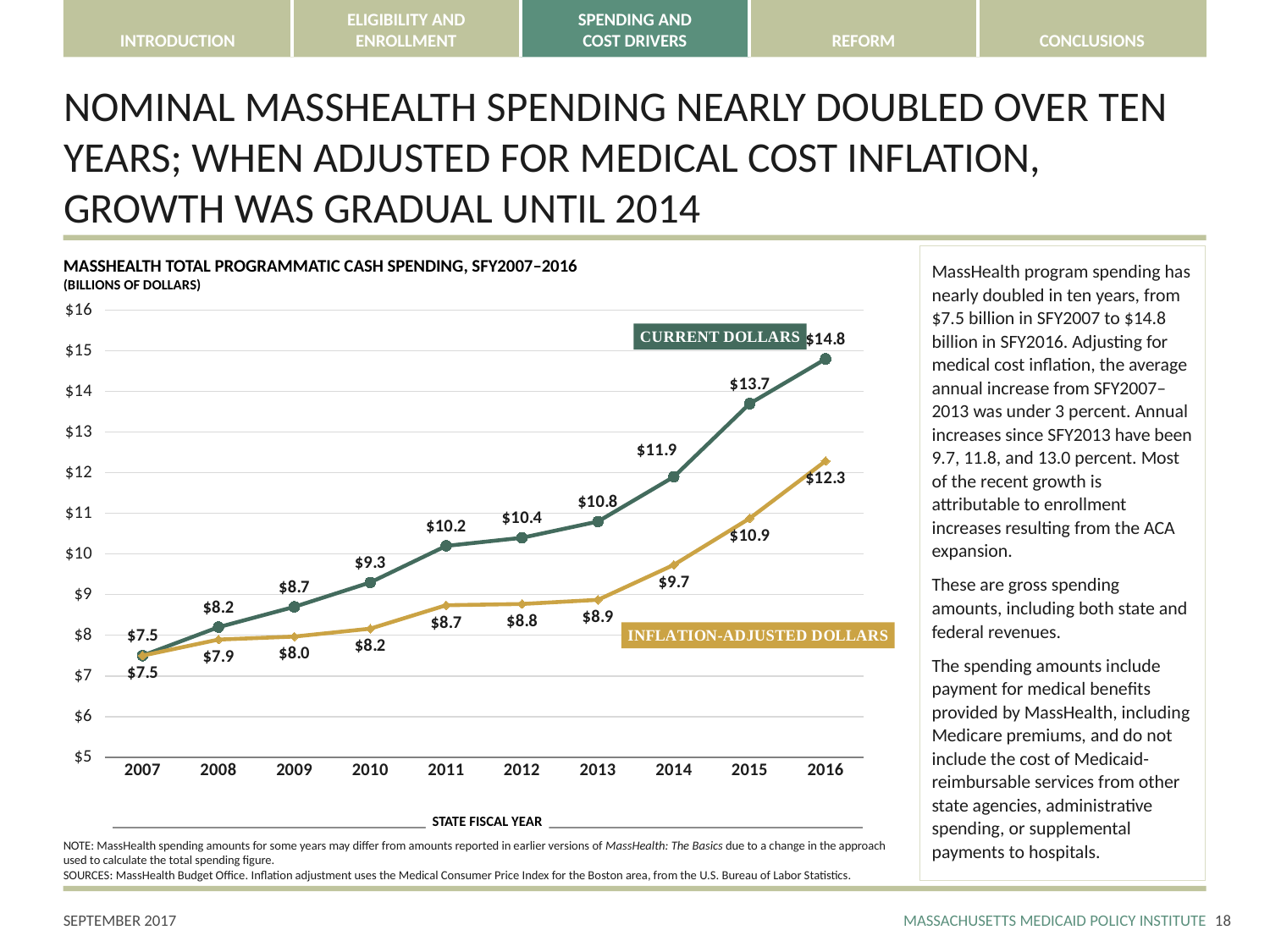
What is the difference between current dollars and inflation-adjusted dollars in 2015? $2.8 In which year was inflation-adjusted spending lowest? 2007 What is the label on the x axis? STATE FISCAL YEAR Which is larger in 2014: current dollars or inflation-adjusted dollars? Current dollars What was the inflation-adjusted spending value for 2013? $8.9 In which year was current-dollar spending highest? 2016 What kind of chart is this? Line chart How many years are shown on the x axis? 10 How many data series does the chart show? 2 What was the current-dollar spending value for 2011? $10.2 Do current-dollar spending values rise or fall from 2007 to 2016? Rise What was MassHealth spending in current dollars in 2016? $14.8